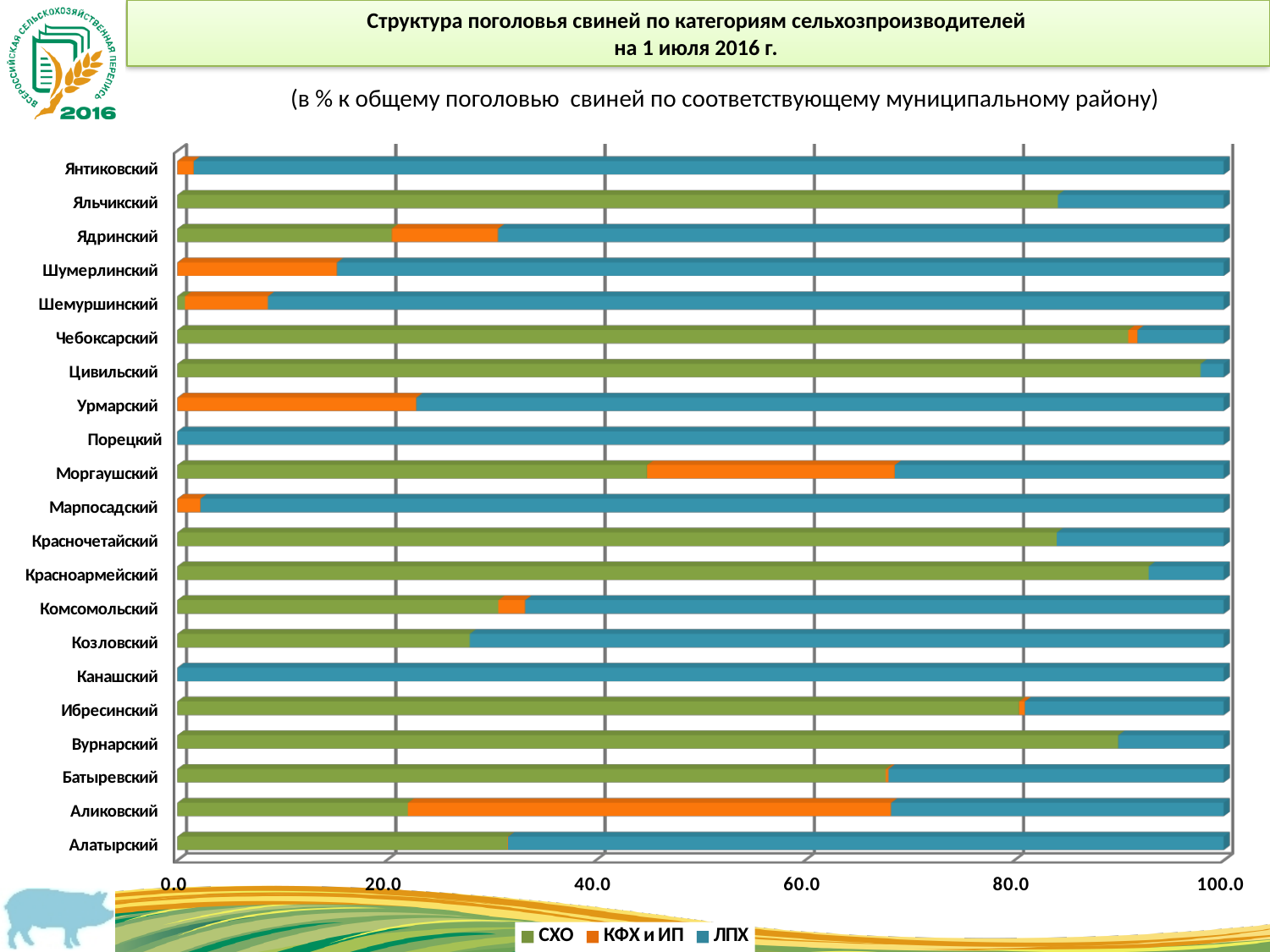
Which district has the largest СХО share? Цивильский Which series are listed in the legend? СХО, КФХ и ИП, ЛПХ Is the СХО value for Козловский greater or less than 40.0? less How many series does the legend list? 3 Is the СХО value for Алатырский greater or less than 20.0? greater How many districts (categories) are plotted on the chart? 21 Is the СХО value for Цивильский greater or less than 80.0? greater What kind of chart is shown on the slide? stacked bar chart Which district has the largest КФХ и ИП share? Аликовский Which colour represents ЛПХ in the chart? blue Which district has the larger СХО share, Яльчикский or Козловский? Яльчикский